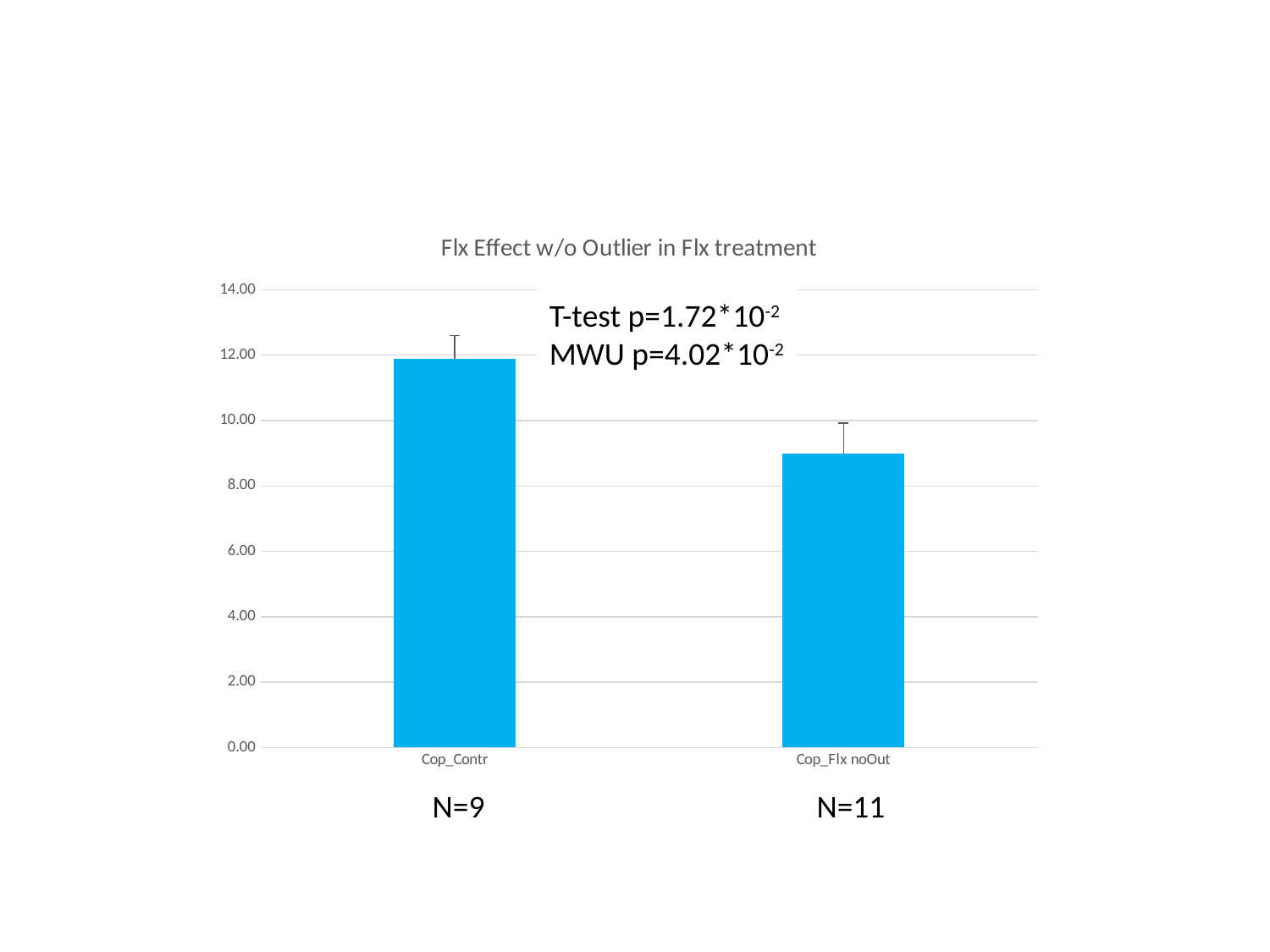
What is the sample size (N) shown under the Cop_Flx noOut bar? N=11 Which category has the highest bar? Cop_Contr What is the maximum value shown on the y axis? 14.00 How many bars does the chart have? 2 Which category has the lowest bar? Cop_Flx noOut What kind of chart is shown on the slide? bar chart Is the value for Cop_Flx noOut greater or less than 8.00? greater What is the title of the chart? Flx Effect w/o Outlier in Flx treatment Is the value for Cop_Contr greater or less than 10.00? greater Is the value for Cop_Flx noOut greater or less than 10.00? less Which is larger, the value for Cop_Contr or the value for Cop_Flx noOut? Cop_Contr